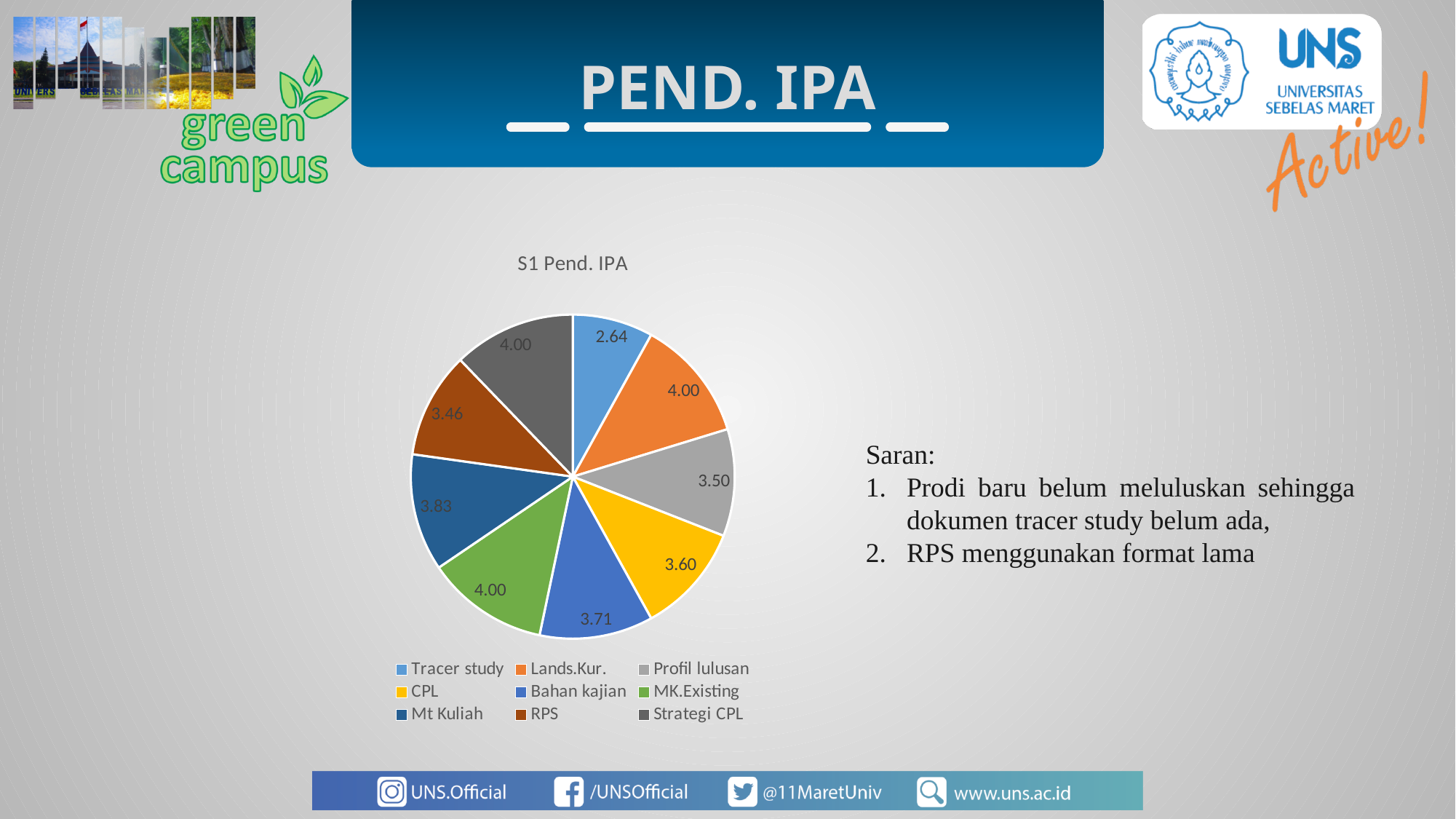
What is the value for RPS in the S1 Pend. IPA pie chart? 3.46 What is the title of the chart on the slide? S1 Pend. IPA What is the value for Tracer study in the S1 Pend. IPA pie chart? 2.64 What kind of chart is shown on the slide? Pie chart How many categories are shown in the S1 Pend. IPA pie chart? 9 What is the value for Profil lulusan in the S1 Pend. IPA pie chart? 3.50 What is the difference between the values for Mt Kuliah and RPS in the S1 Pend. IPA pie chart? 0.37 What is the value for Bahan kajian in the S1 Pend. IPA pie chart? 3.71 Which has a larger value in the S1 Pend. IPA pie chart, Bahan kajian or CPL? Bahan kajian Which category has the lowest value in the S1 Pend. IPA pie chart? Tracer study What is the value for Mt Kuliah in the S1 Pend. IPA pie chart? 3.83 What is the difference between the values for Lands.Kur. and Tracer study in the S1 Pend. IPA pie chart? 1.36